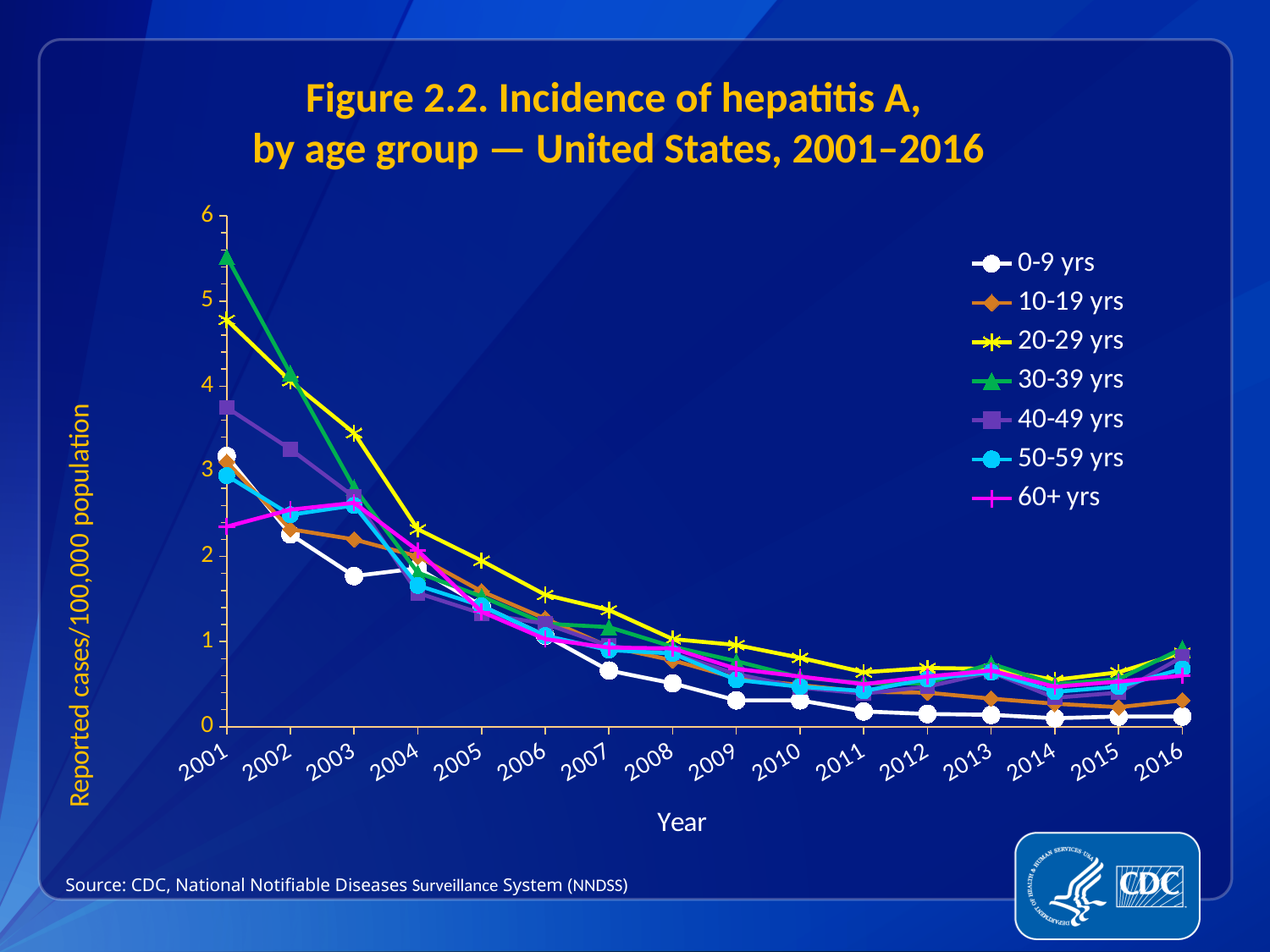
Which age group had the highest incidence of hepatitis A in 2001? 30-39 yrs What is the label of the y axis? Reported cases/100,000 population Overall, does the incidence for the 20-29 yrs group rise or fall from 2001 to 2016? fall How many age-group series does the legend list? 7 How many years are plotted along the x axis? 16 Is the 2001 value for the 20-29 yrs group greater or less than 5? less Is the 2001 value for the 30-39 yrs group greater or less than 5? greater Which age group had the lowest incidence of hepatitis A in 2016? 0-9 yrs Which age group had the lowest incidence of hepatitis A in 2001? 60+ yrs Is the 2016 value for the 0-9 yrs group greater or less than 1? less What kind of chart is shown on the slide? line chart In 2001, which had the higher incidence: the 20-29 yrs group or the 40-49 yrs group? 20-29 yrs